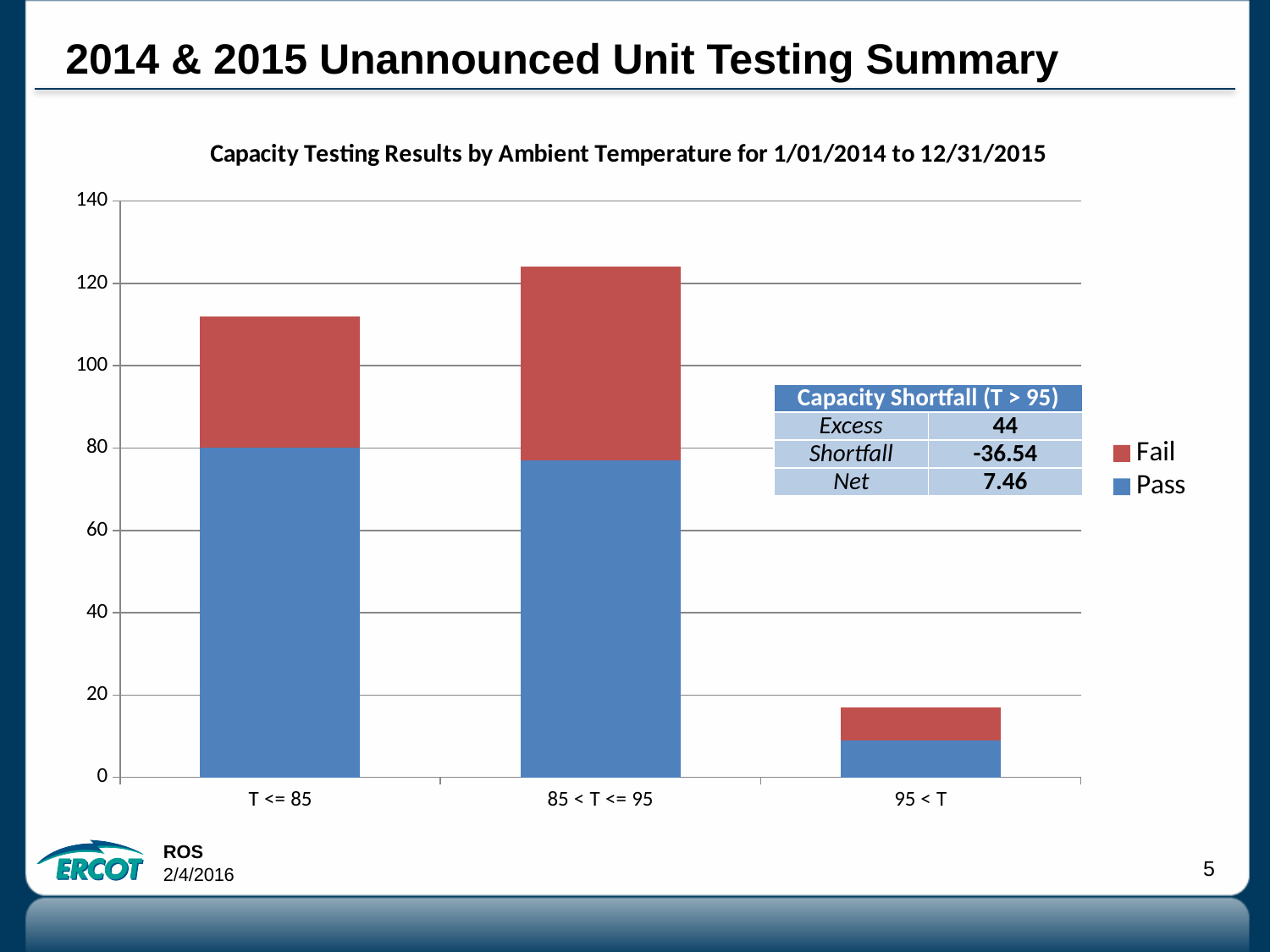
How many temperature categories are shown on the x axis? 3 What is the Net value shown in the Capacity Shortfall (T > 95) table? 7.46 What kind of chart is shown on the slide? bar chart Which stacked bar is taller, T <= 85 or 85 < T <= 95? 85 < T <= 95 Which temperature category has the tallest stacked bar? 85 < T <= 95 Is the total height of the bar for 95 < T greater or less than 20? less Is the total height of the bar for 85 < T <= 95 greater or less than 120? greater Which temperature category has the shortest stacked bar? 95 < T How many series does the legend list? 2 Which colour represents the Fail series in the legend? red Is the total height of the bar for T <= 85 greater or less than 100? greater Within the T <= 85 bar, which segment is larger, Pass or Fail? Pass